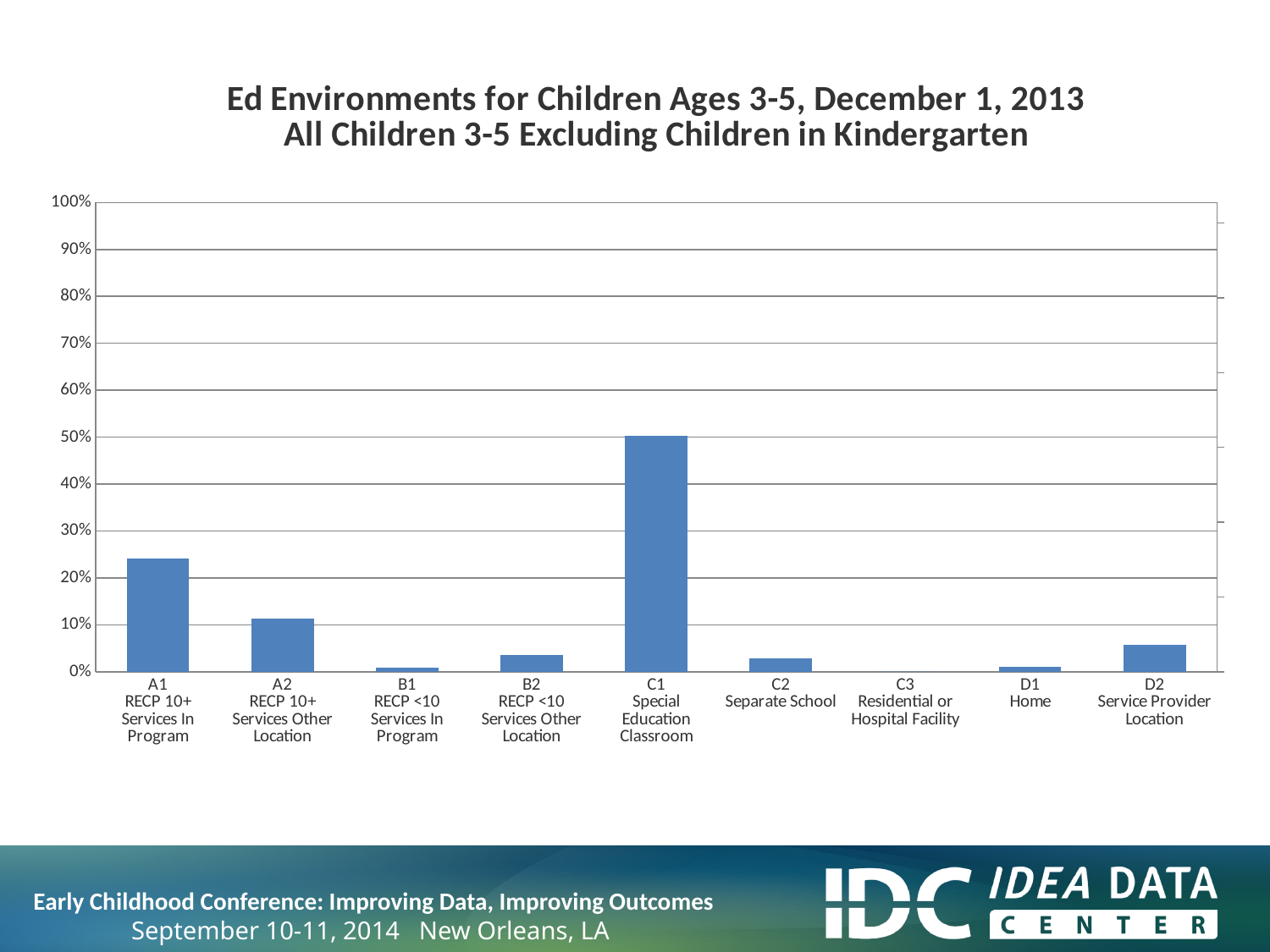
What kind of chart is shown on the slide? bar chart How many categories are shown on the x axis of the chart? 9 Is the value for A2 RECP 10+ Services Other Location greater or less than 20%? less Which category has the lowest value in the chart? C3 Residential or Hospital Facility Is the value for C1 Special Education Classroom greater or less than 40%? greater Which category has the highest value in the chart? C1 Special Education Classroom Which is larger, the value for A1 RECP 10+ Services In Program or A2 RECP 10+ Services Other Location? A1 RECP 10+ Services In Program Which is larger, the value for D2 Service Provider Location or C2 Separate School? D2 Service Provider Location What date is given in the chart title? December 1, 2013 Is the value for C1 Special Education Classroom greater or less than 60%? less